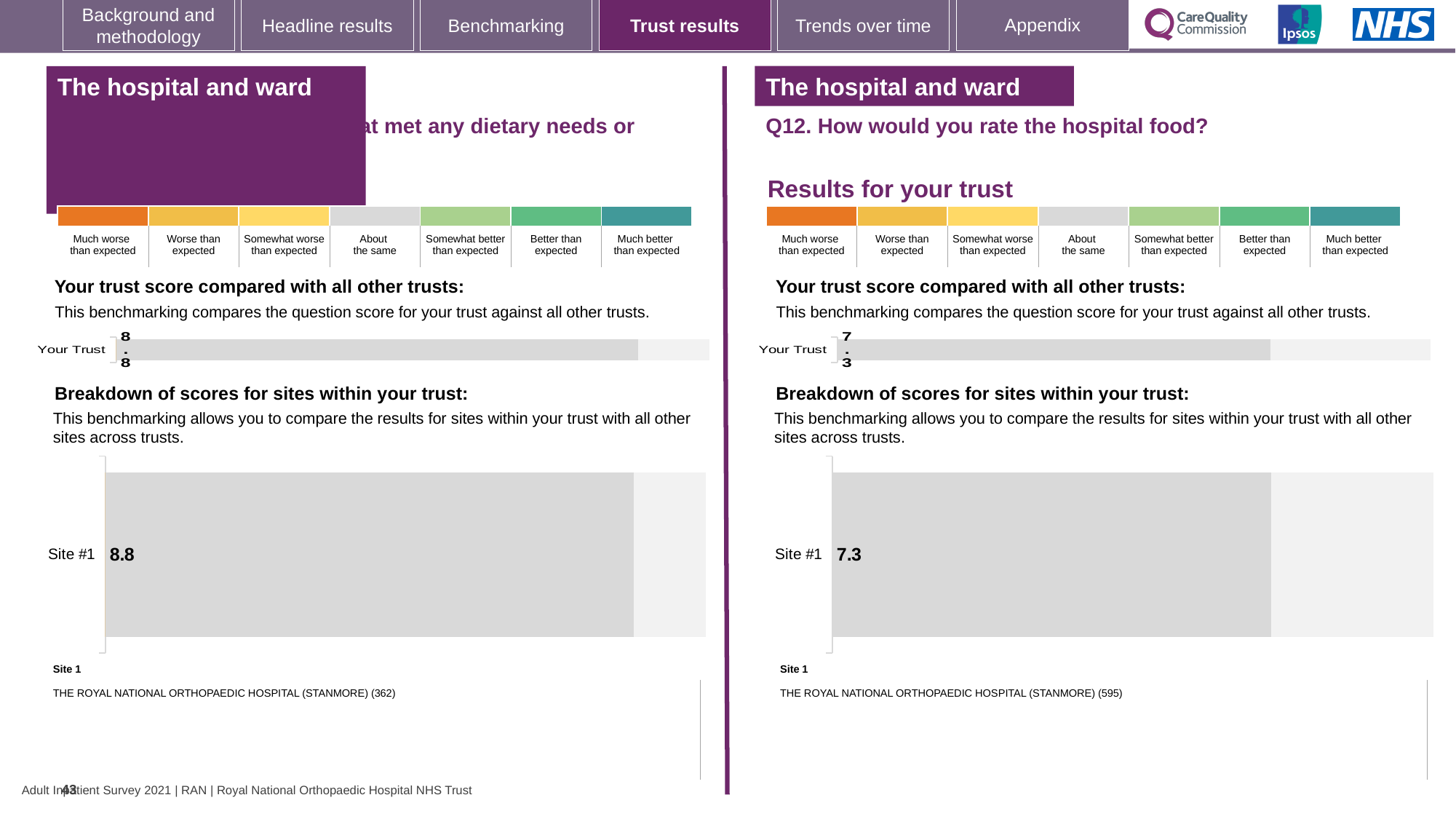
What kind of chart is used to show the Site #1 score on the right-hand side of the slide? Bar chart What is the question title shown above the charts on the right-hand side of the slide? Q12. How would you rate the hospital food? Which is larger: the Site #1 score on the left-hand side of the slide or the Site #1 score on the right-hand side (Q12)? Left-hand side (8.8) On the right-hand side of the slide (Q12, hospital food), what is the score shown for Site #1? 7.3 How many sites are shown in the breakdown of scores chart on the right-hand side of the slide? 1 What is the difference between the Site #1 score on the left-hand side of the slide and the Site #1 score on the right-hand side (Q12)? 1.5 How many sites are shown in the breakdown of scores chart on the left-hand side of the slide? 1 On the left-hand side of the slide, what is the score shown for Site #1 in the breakdown of scores chart? 8.8 On the right-hand side of the slide (Q12, hospital food), what is the score shown for Your Trust? 7.3 Which site name is listed as Site 1 below the breakdown chart on the right-hand side of the slide? THE ROYAL NATIONAL ORTHOPAEDIC HOSPITAL (STANMORE) (595) On the left-hand side of the slide, what is the score shown for Your Trust? 8.8